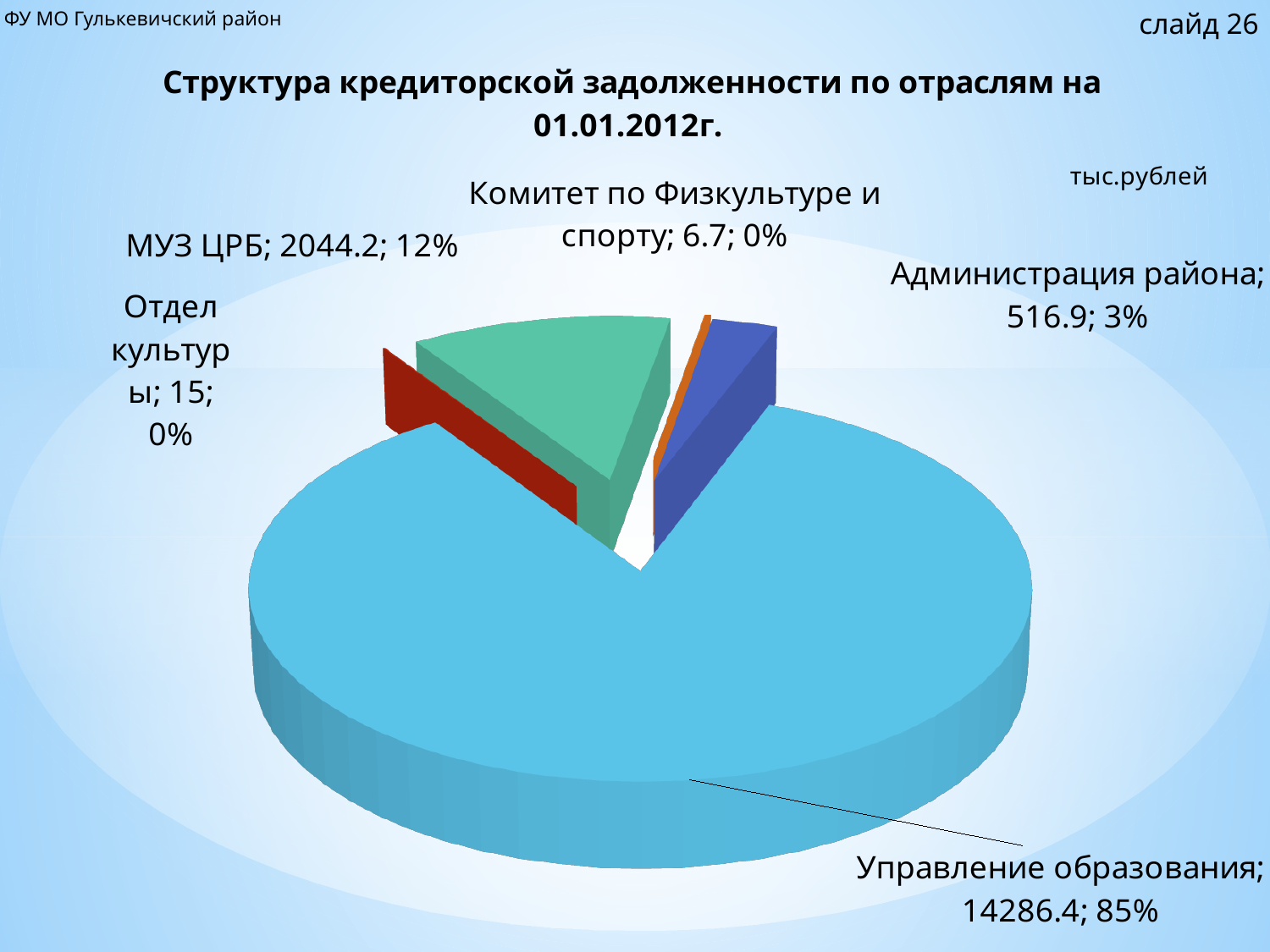
What share of the pie does МУЗ ЦРБ represent? 12% What is the value for Администрация района? 516.9 Which is larger, the value for Отдел культуры or the value for Комитет по Физкультуре и спорту? Отдел культуры What kind of chart is shown on the slide? pie chart Which category has the smallest value? Комитет по Физкультуре и спорту How many slices does the pie chart have? 5 What is the value for МУЗ ЦРБ? 2044.2 What is the value for Комитет по Физкультуре и спорту? 6.7 What is the difference between the values for МУЗ ЦРБ and Администрация района? 1527.3 Which category has the largest share of the pie? Управление образования What is the value for Управление образования? 14286.4 What is the value for Отдел культуры? 15